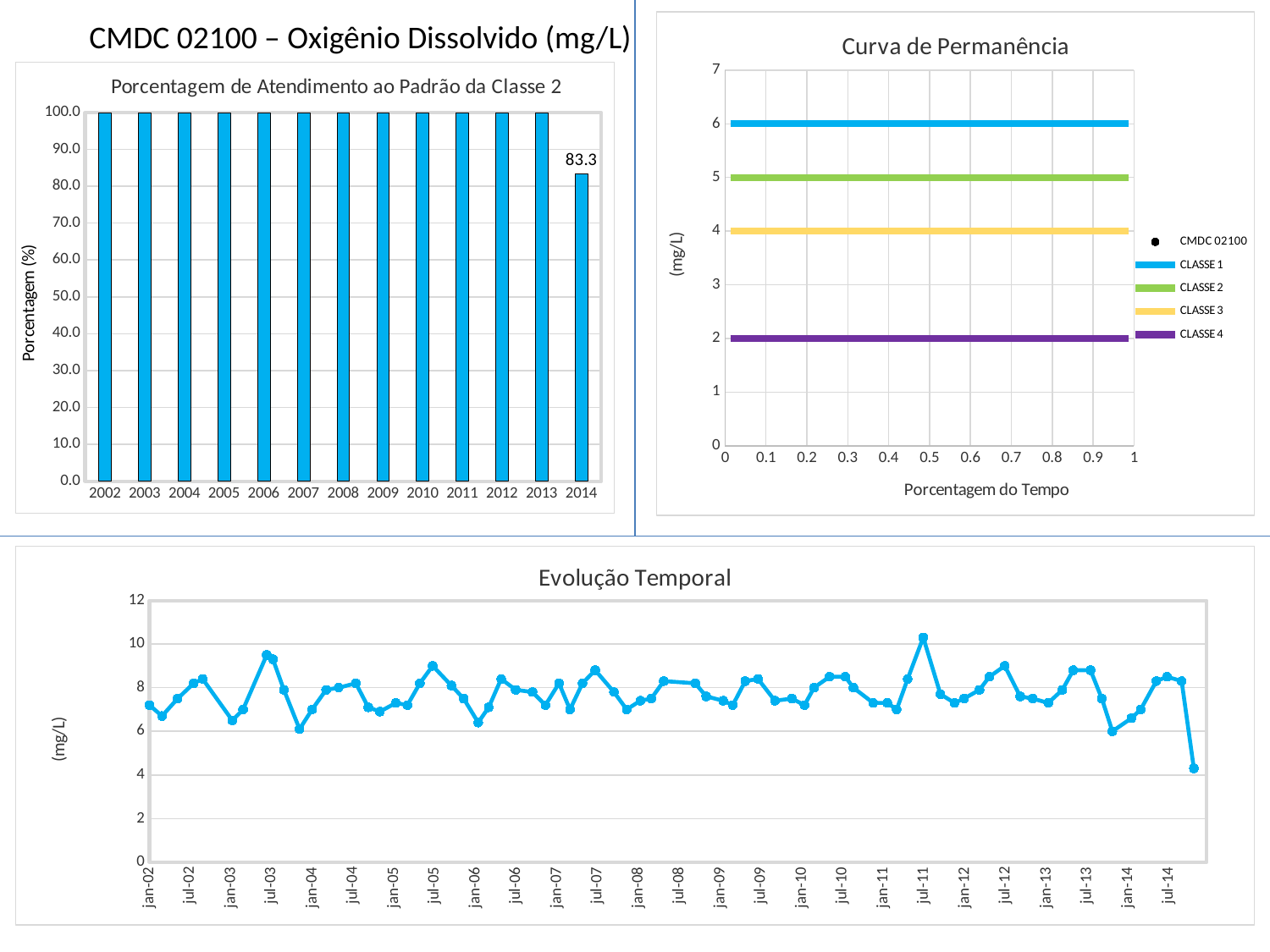
In the chart titled "Curva de Permanência", at what value (mg/L) is the CLASSE 4 line drawn? 2 In the chart titled "Porcentagem de Atendimento ao Padrão da Classe 2", which year has the lowest value? 2014 In the chart titled "Porcentagem de Atendimento ao Padrão da Classe 2", what kind of chart is it? bar chart In the chart titled "Curva de Permanência", how many entries does the legend list? 5 In the chart titled "Porcentagem de Atendimento ao Padrão da Classe 2", what is the label of the y axis? Porcentagem (%) In the chart titled "Curva de Permanência", what is the label of the x axis? Porcentagem do Tempo In the chart titled "Evolução Temporal", is the value at jul-11 greater or less than 10? greater In the chart titled "Porcentagem de Atendimento ao Padrão da Classe 2", what is the value for 2014? 83.3 In the chart titled "Porcentagem de Atendimento ao Padrão da Classe 2", is the value for 2013 larger or smaller than the value for 2014? larger In the chart titled "Curva de Permanência", at what value (mg/L) is the CLASSE 1 line drawn? 6 In the chart titled "Porcentagem de Atendimento ao Padrão da Classe 2", how many years are shown on the x axis? 13 In the chart titled "Evolução Temporal", is the last plotted value (after jul-14) greater or less than 6? less